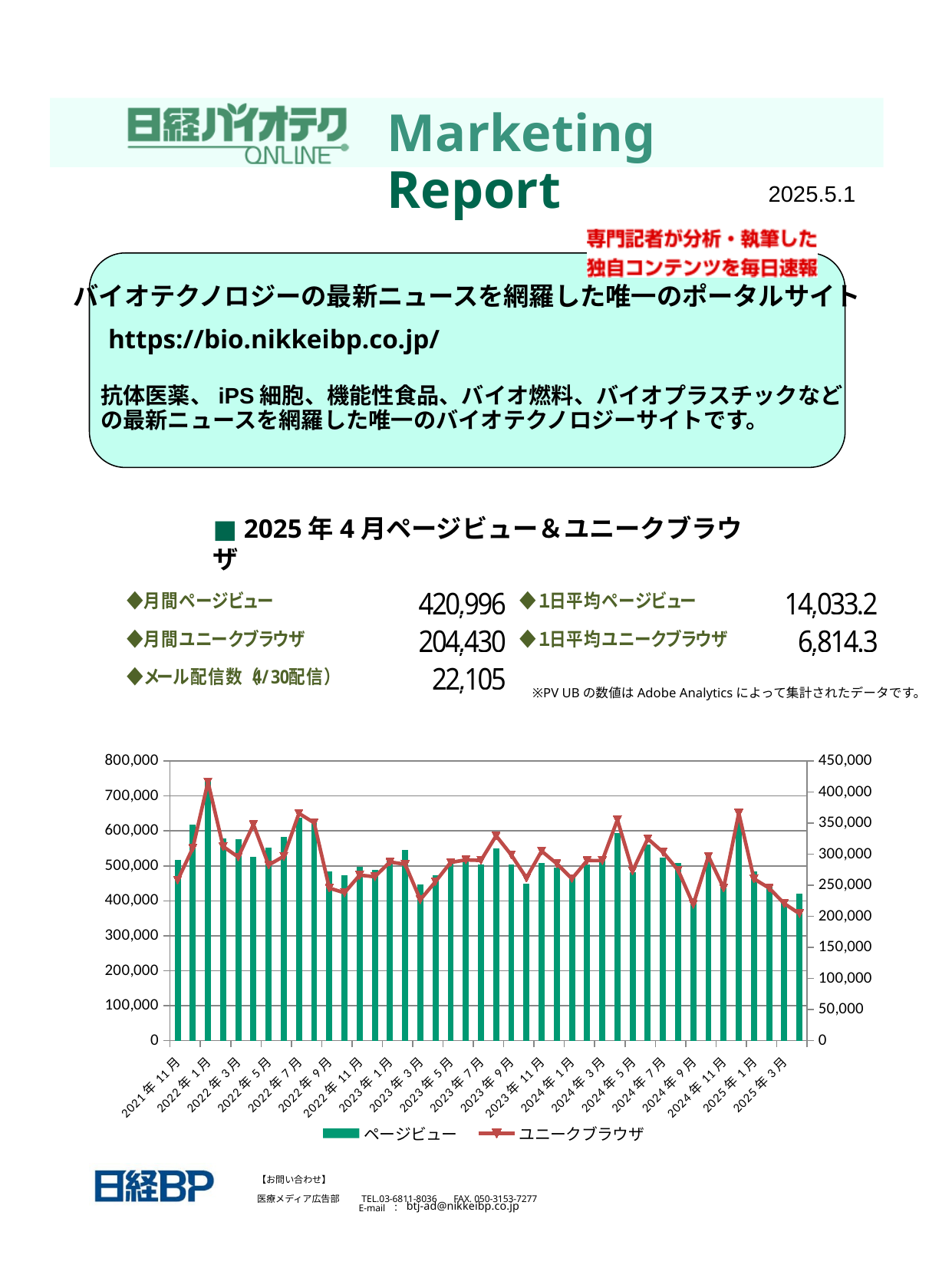
Is the ユニークブラウザ value for 2022年1月 greater or less than 350,000? greater What kind of chart is shown on the slide? A combination bar and line chart Does the ユニークブラウザ line rise or fall from 2025年1月 to 2025年3月? fall Is the ページビュー value for 2021年11月 greater or less than 600,000? less Which month has the higher ページビュー value, 2021年11月 or 2022年1月? 2022年1月 Is the ユニークブラウザ value for 2025年3月 greater or less than 250,000? less How many series does the chart legend list? 2 In which month does the ユニークブラウザ line reach its highest value? 2022年1月 In which month do the ページビュー bars reach their highest value? 2022年1月 What are the two series named in the chart legend? ページビュー and ユニークブラウザ Which series is drawn as bars in the chart? ページビュー